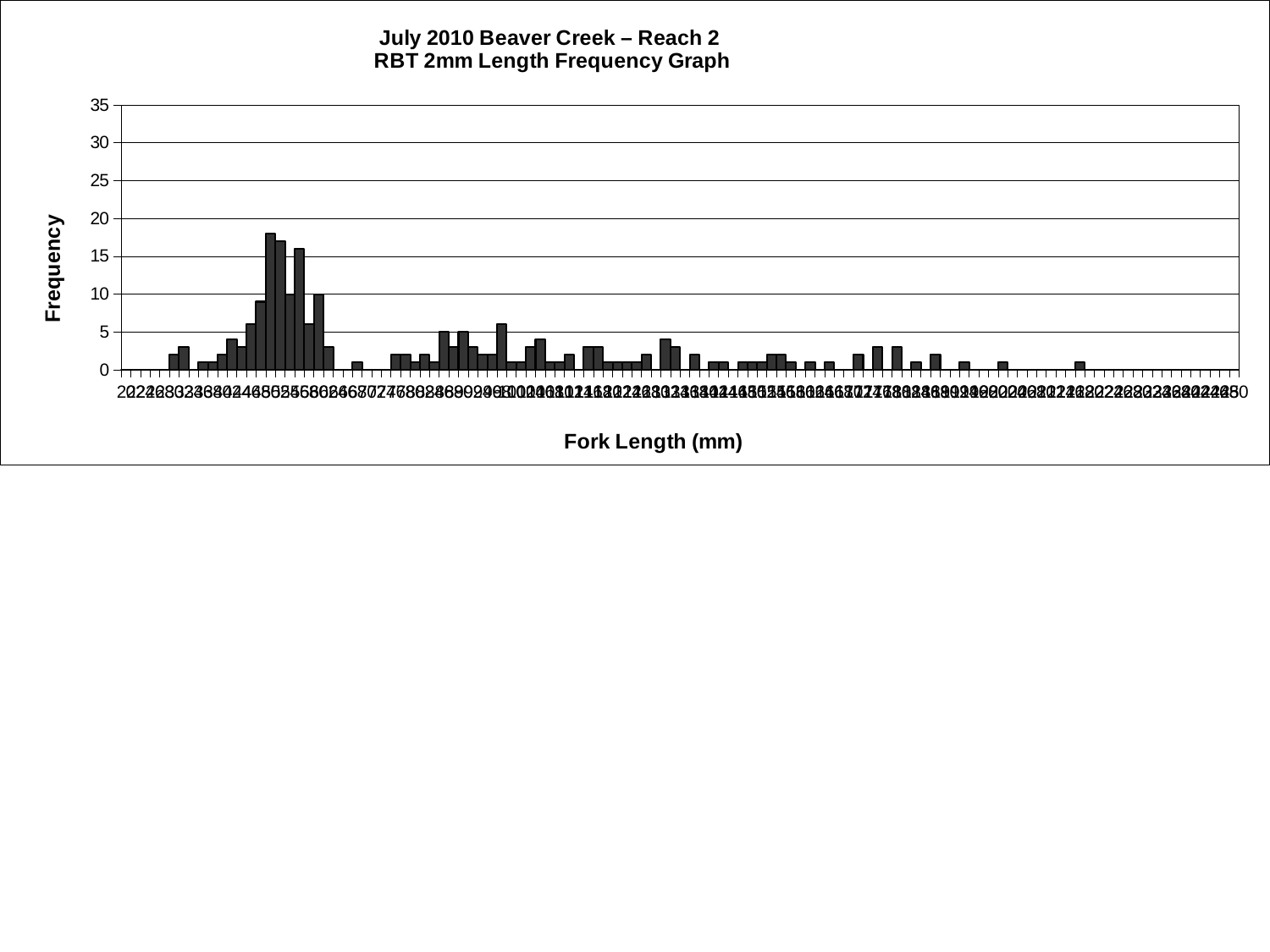
Is the highest frequency reached by any bar greater or less than 10? greater What kind of chart is shown on the slide? bar chart Is the highest frequency reached by any bar greater or less than 20? less What is the title of the chart? July 2010 Beaver Creek – Reach 2 RBT 2mm Length Frequency Graph What is the label on the x axis of the chart? Fork Length (mm) Is the highest frequency reached by any bar greater or less than 15? greater